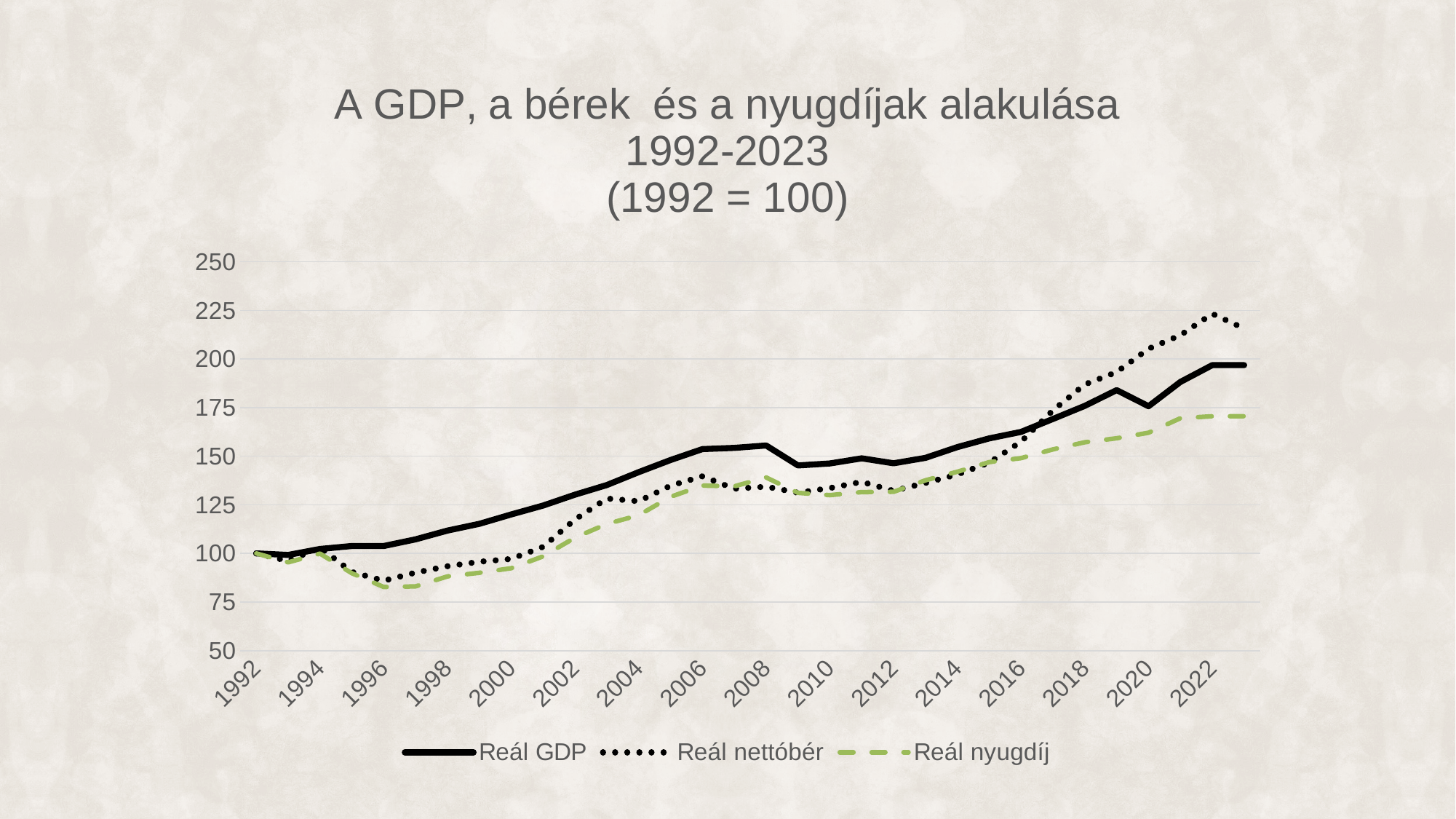
Does the Reál nettóbér series rise or fall between 1992 and 1996? fall What is the value of Reál GDP in 1992? 100 What is the title of the chart? A GDP, a bérek és a nyugdíjak alakulása 1992-2023 (1992 = 100) What kind of chart is shown on the slide? line chart Is the value for Reál nyugdíj in 1997 greater or less than 100? less Which series has the highest value in 2023? Reál nettóbér How many series does the legend list? 3 Is the value for Reál GDP in 2008 greater or less than 150? greater In 2010, which is larger: Reál GDP or Reál nyugdíj? Reál GDP Which series has the lowest value in 2023? Reál nyugdíj Is the value for Reál nettóbér in 2022 greater or less than 200? greater